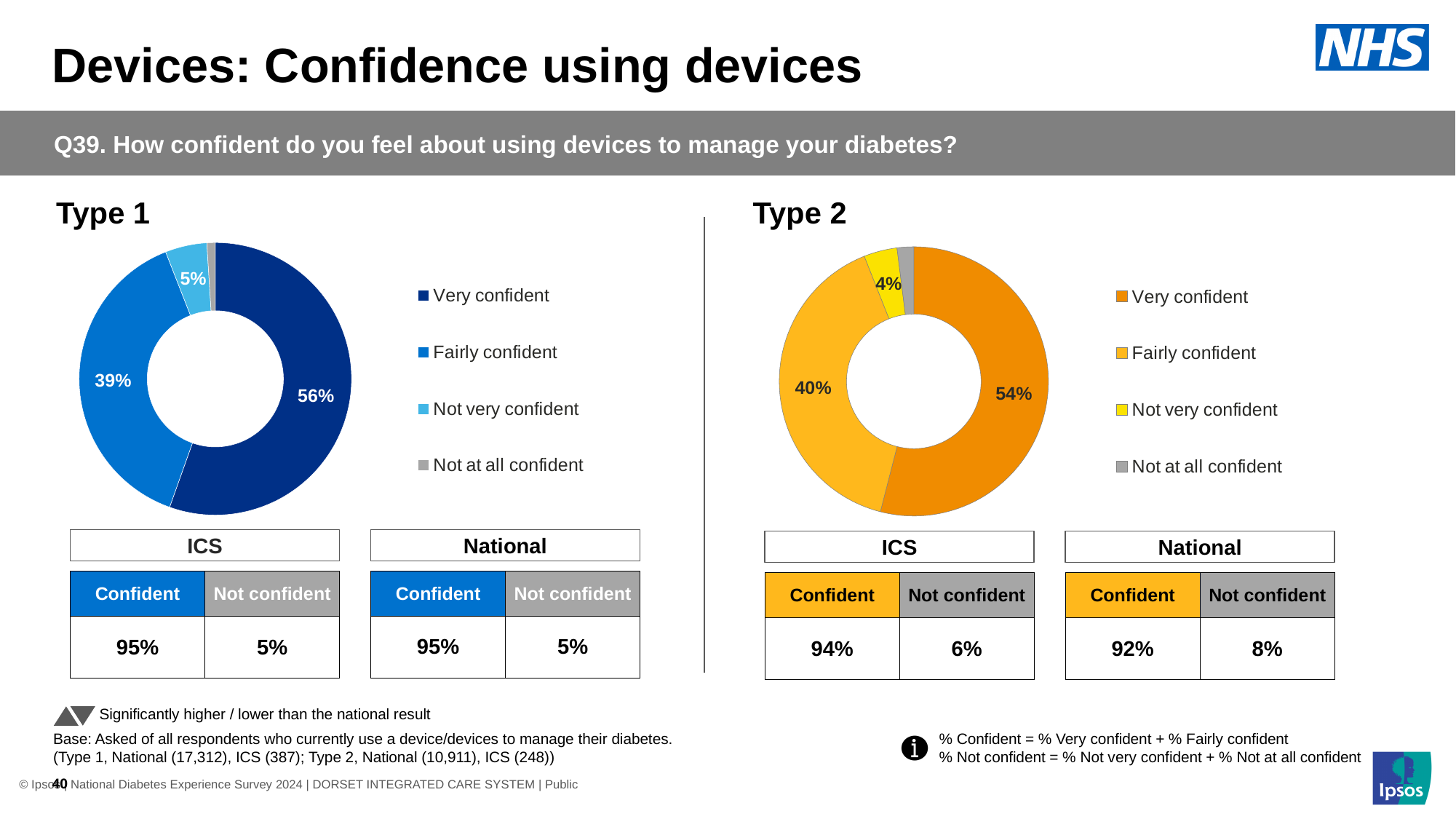
How many categories does the legend of the Type 2 chart list? 4 Which chart has the larger share for very confident, Type 1 or Type 2? Type 1 In the Type 2 chart, what is the difference between the very confident and fairly confident shares? 14 percentage points In the Type 2 chart, what percentage of respondents are not very confident? 4% In the Type 1 chart, which category has the largest share? Very confident In the Type 2 chart, which category has the largest share? Very confident In the Type 1 chart, what percentage of respondents are fairly confident? 39% What type of chart is used for Type 1? Doughnut chart In the Type 1 chart, what is the difference between the very confident and fairly confident shares? 17 percentage points In the Type 1 chart, what percentage of respondents are very confident? 56% In the Type 1 chart, what colour represents the not at all confident category? Grey In the Type 2 chart, what percentage of respondents are very confident? 54%